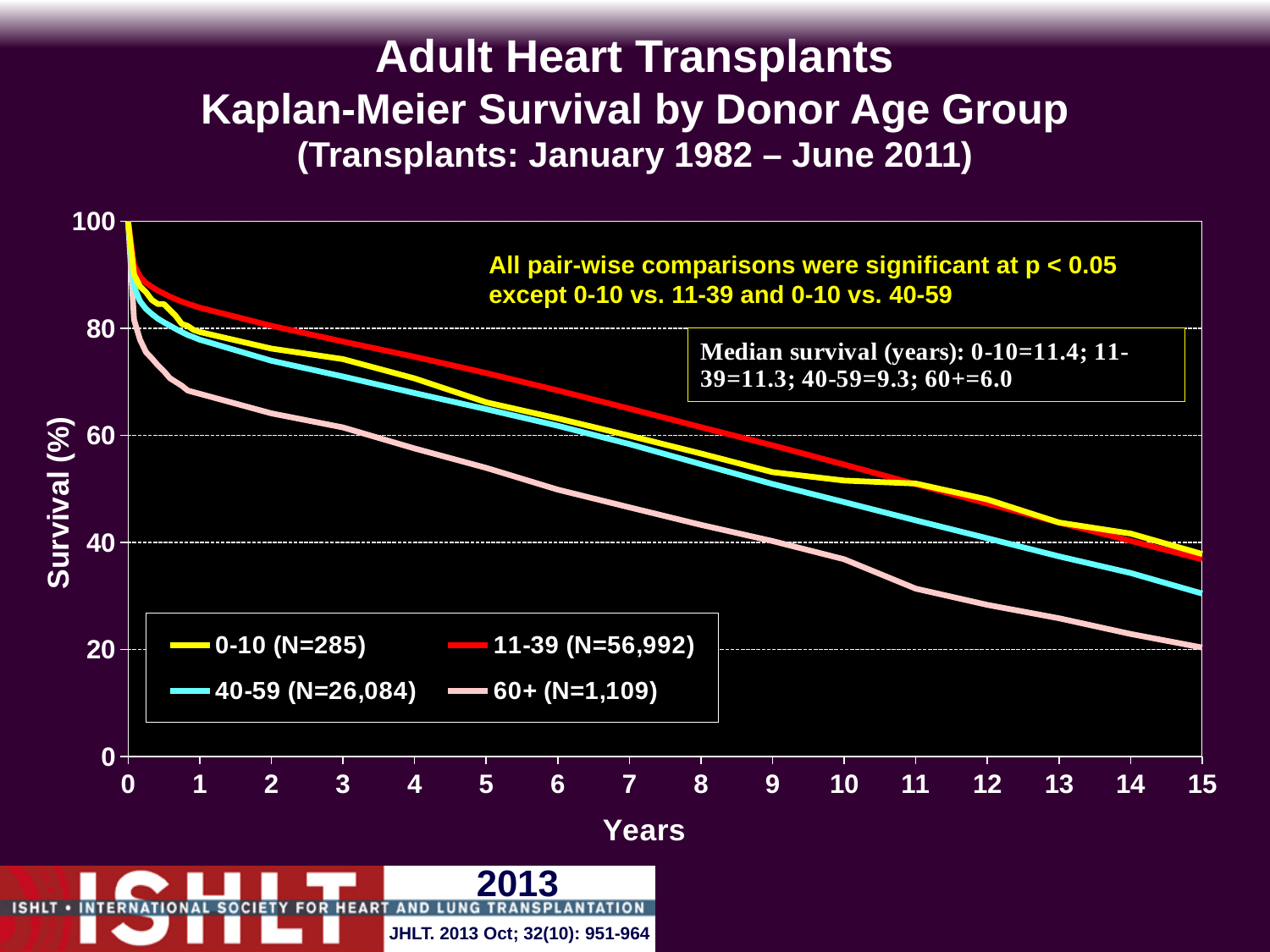
According to the text box, what is the median survival in years for the 60+ donor age group? 6.0 At 5 years, which group has higher survival: 11-39 or 60+? 11-39 What is the difference in median survival (years) between the 0-10 group and the 60+ group? 5.4 Do the survival curves rise or fall as years increase? fall What kind of chart is shown on the slide? line chart Is the survival value for the 11-39 group at 5 years greater or less than 60? greater What is the N shown in the legend for the 11-39 donor age group? 56,992 Is the survival value for the 60+ group at 10 years greater or less than 40? less Which donor age group's survival curve is lowest across the whole chart? 60+ (N=1,109) Which donor age group has the lowest median survival shown in the text box? 60+ According to the text box, what is the median survival in years for the 0-10 donor age group? 11.4 How many donor age groups (series) does the legend list? 4